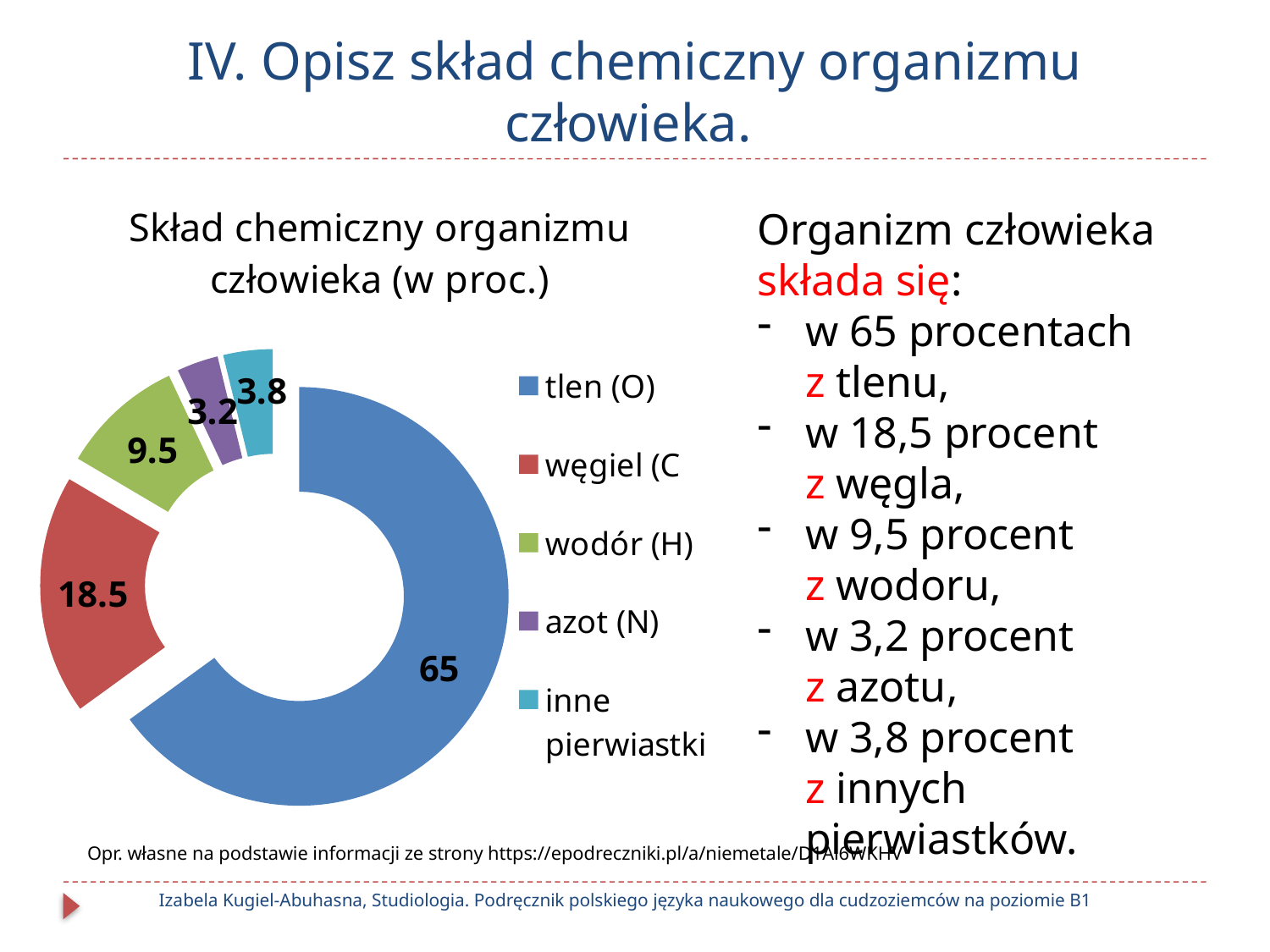
What is the value for tlen (O) in the chart? 65 What is the difference between the values for tlen (O) and węgiel (C)? 46.5 What is the value for inne pierwiastki in the chart? 3.8 Which is larger, the value for wodór (H) or the value for inne pierwiastki? wodór (H) Which category has the largest share in the chart? tlen (O) Which category has the smallest share in the chart? azot (N) What kind of chart is shown on the slide? doughnut chart What is the value for wodór (H) in the chart? 9.5 What is the value for azot (N) in the chart? 3.2 How many categories does the chart show? 5 What is the value for węgiel (C) in the chart? 18.5 What is the title of the chart? Skład chemiczny organizmu człowieka (w proc.)